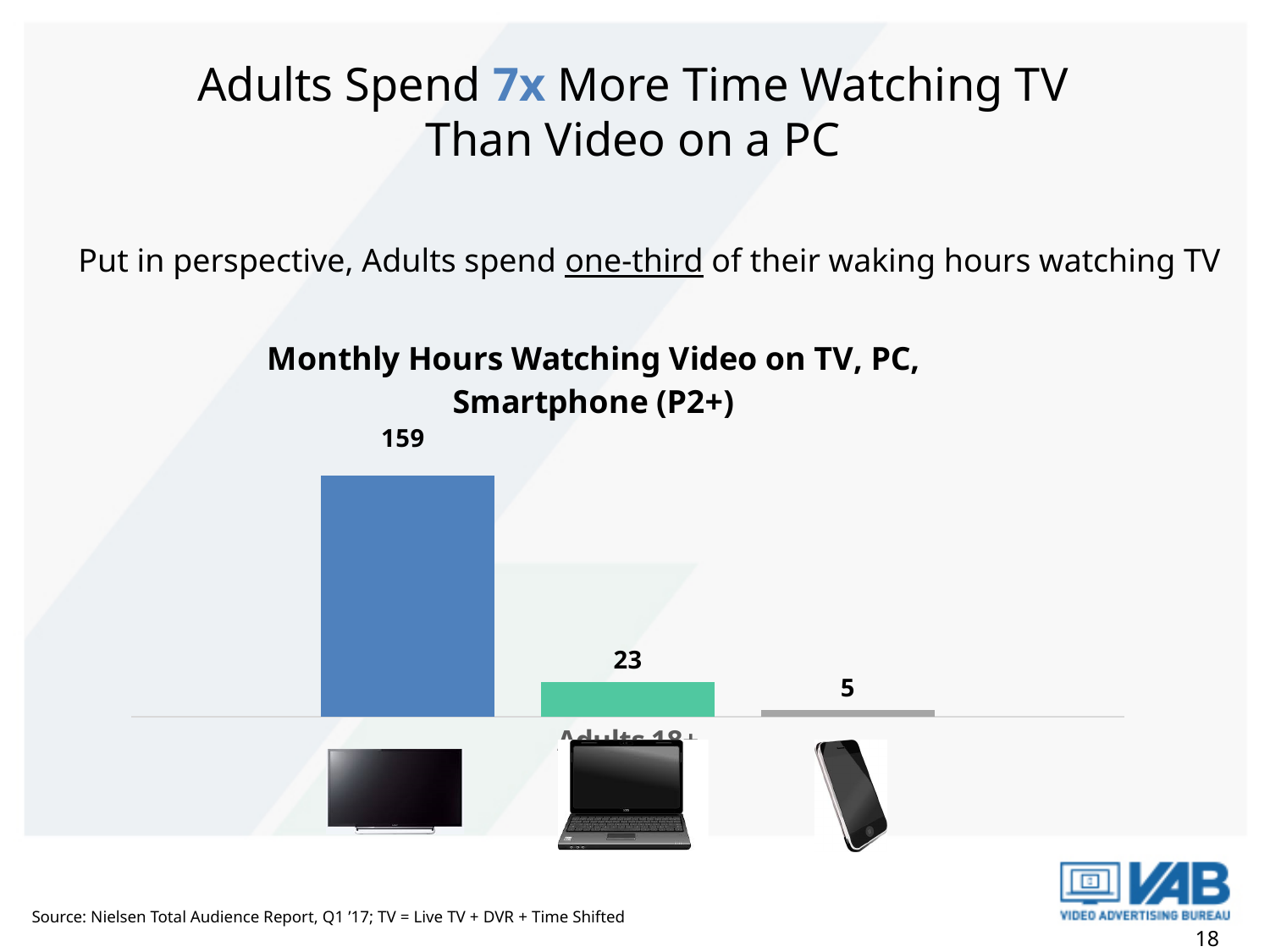
What kind of chart is shown on the slide? Bar chart How many bars are shown in the chart? 3 What is the title of the chart? Monthly Hours Watching Video on TV, PC, Smartphone (P2+) What is the value for TV in the Monthly Hours Watching Video chart? 159 What is the difference in monthly hours between TV and PC? 136 What is the value for PC in the Monthly Hours Watching Video chart? 23 Which device has the highest monthly hours watching video? TV Which is larger, the monthly hours for PC or for Smartphone? PC Which device has the lowest monthly hours watching video? Smartphone What is the value for Smartphone in the Monthly Hours Watching Video chart? 5 What is the difference in monthly hours between PC and Smartphone? 18 Do the values rise or fall from left to right across the chart? Fall